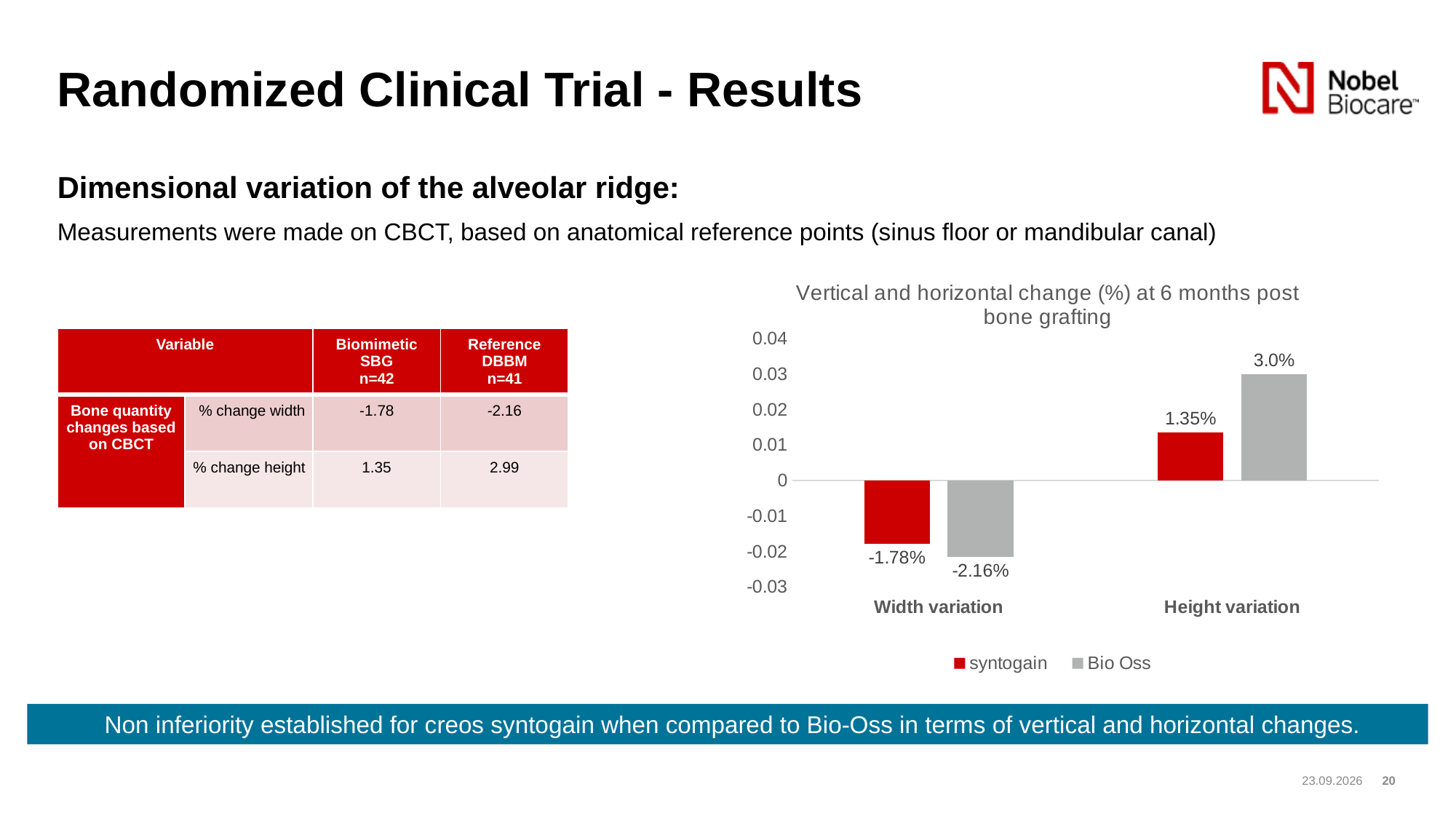
What is the value for Bio Oss in the Width variation category? -2.16% Which bar in the chart has the highest value? Bio Oss, Height variation How many categories are shown on the x axis? 2 What is the value for syntogain in the Height variation category? 1.35% Which bar in the chart has the lowest value? Bio Oss, Width variation How many series does the legend list? 2 What kind of chart is shown on the slide? Bar chart What is the value for Bio Oss in the Height variation category? 3.0% What is the value for syntogain in the Width variation category? -1.78% Which series has the lower value in the Width variation category? Bio Oss Which series has the higher value in the Height variation category? Bio Oss What is the title of the chart? Vertical and horizontal change (%) at 6 months post bone grafting